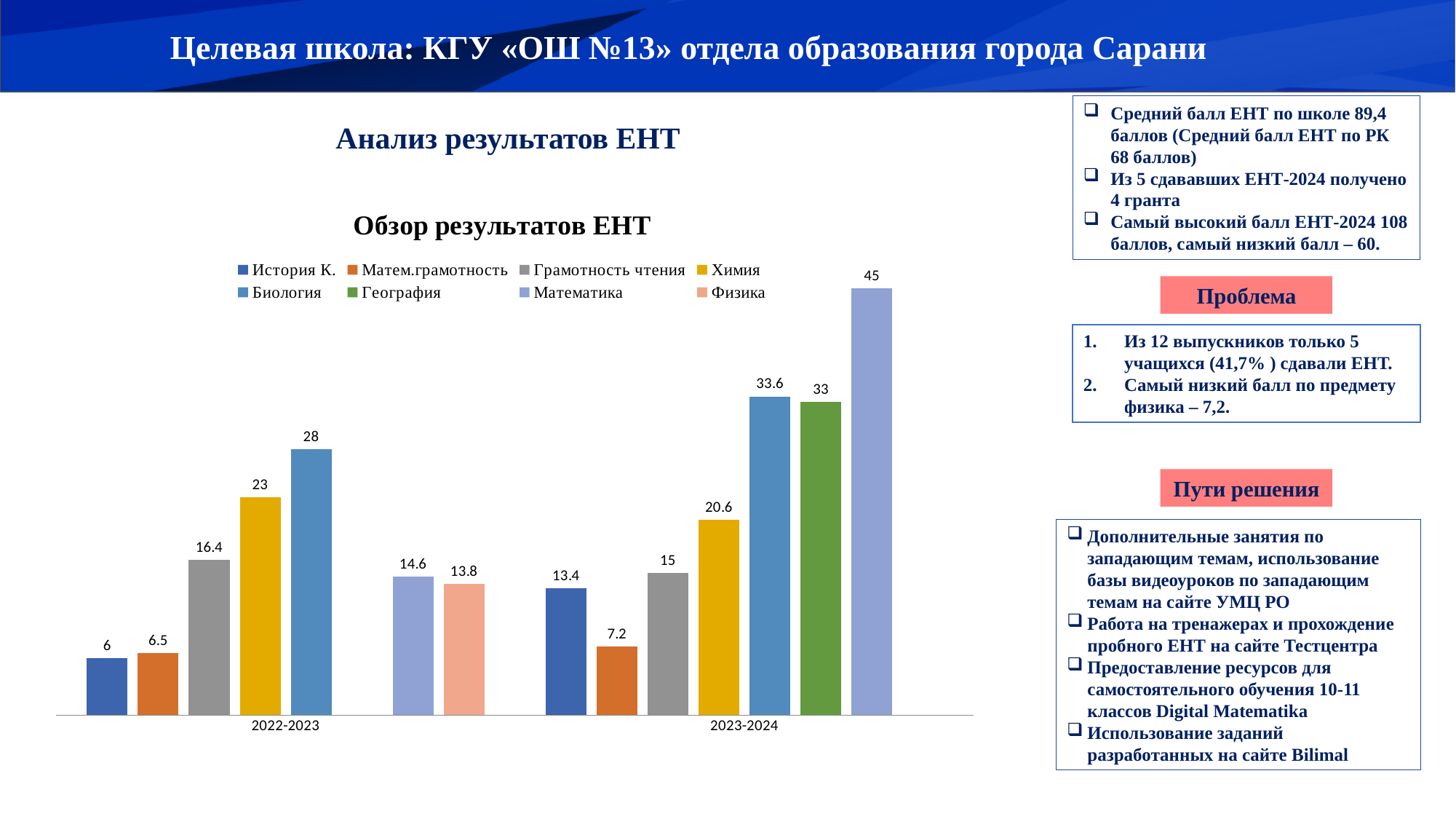
What type of chart is 'Обзор результатов ЕНТ'? bar chart In the 'Обзор результатов ЕНТ' chart, what is the difference between the Химия values for 2022-2023 and 2023-2024? 2.4 In the 'Обзор результатов ЕНТ' chart, what is the value for Математика in 2023-2024? 45 In the 'Обзор результатов ЕНТ' chart, which is larger: Биология in 2023-2024 or География in 2023-2024? Биология in 2023-2024 In the 'Обзор результатов ЕНТ' chart, does the value for История К. rise or fall from 2022-2023 to 2023-2024? rise In the 'Обзор результатов ЕНТ' chart, which series has the highest value in 2023-2024? Математика In the 'Обзор результатов ЕНТ' chart, what is the value for Биология in 2022-2023? 28 In the 'Обзор результатов ЕНТ' chart, what is the value for Физика in 2022-2023? 13.8 How many series does the legend of the 'Обзор результатов ЕНТ' chart list? 8 In the 'Обзор результатов ЕНТ' chart, what is the value for Матем.грамотность in 2023-2024? 7.2 In the 'Обзор результатов ЕНТ' chart, which series has the lowest value in 2022-2023? История К. How many categories are shown on the x axis of the 'Обзор результатов ЕНТ' chart? 2